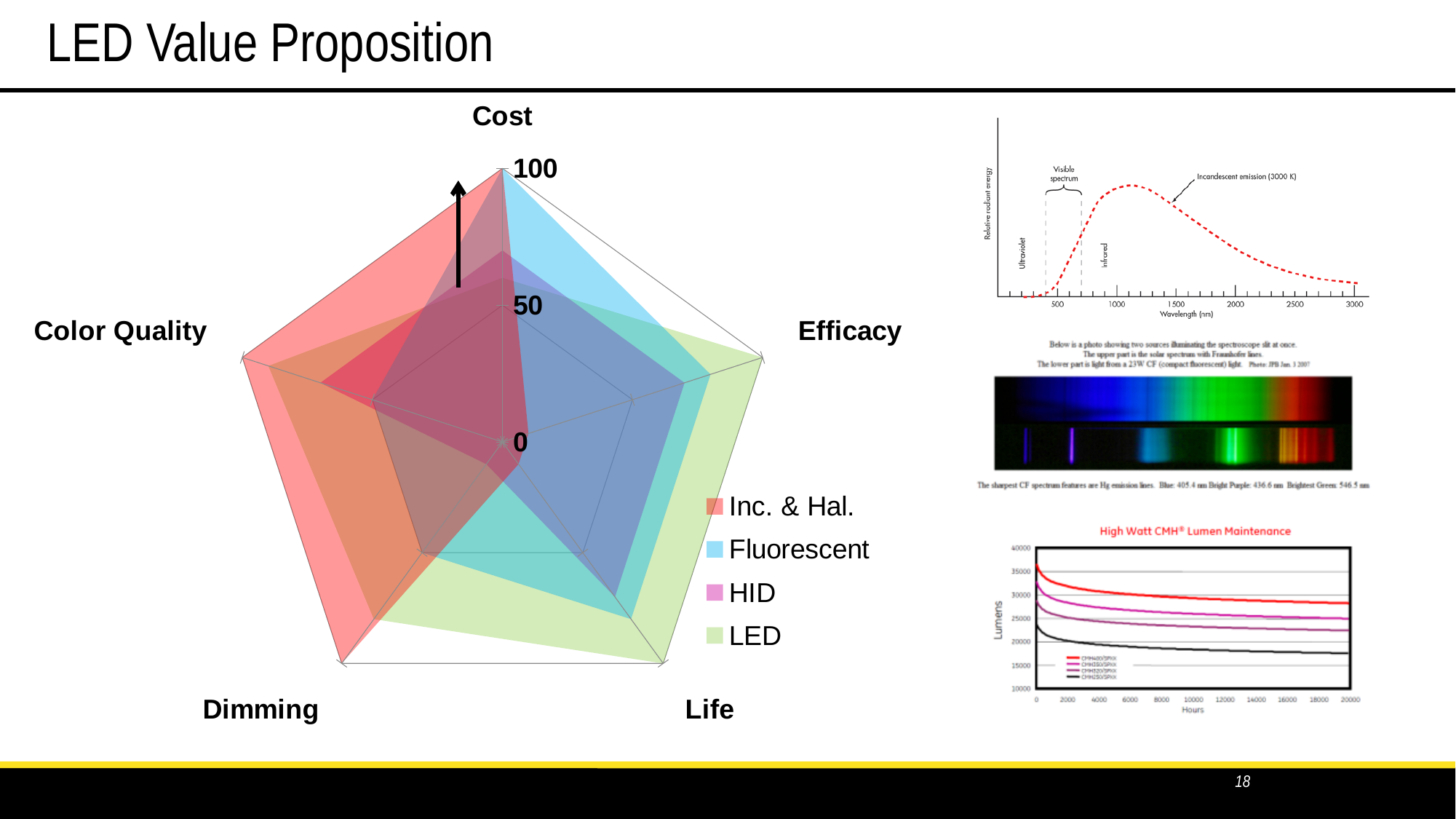
In the radar chart, is the value of Inc. & Hal. for Efficacy greater or less than 50? less In the radar chart, which series has the highest value for Life? LED In the radar chart, is the value of LED for Cost greater or less than 100? less In the radar chart, which series has the lowest value for Cost? LED In the radar chart, which is larger for Efficacy: LED or Inc. & Hal.? LED In the radar chart, what is the value of LED for Life? 100 What are the five axis labels of the radar chart? Cost, Efficacy, Life, Dimming, Color Quality In the radar chart, what is the value of Inc. & Hal. for Cost? 100 How many categories (axes) does the radar chart have? 5 What kind of chart is the chart on the left of the slide? Radar chart How many series does the legend of the radar chart list? 4